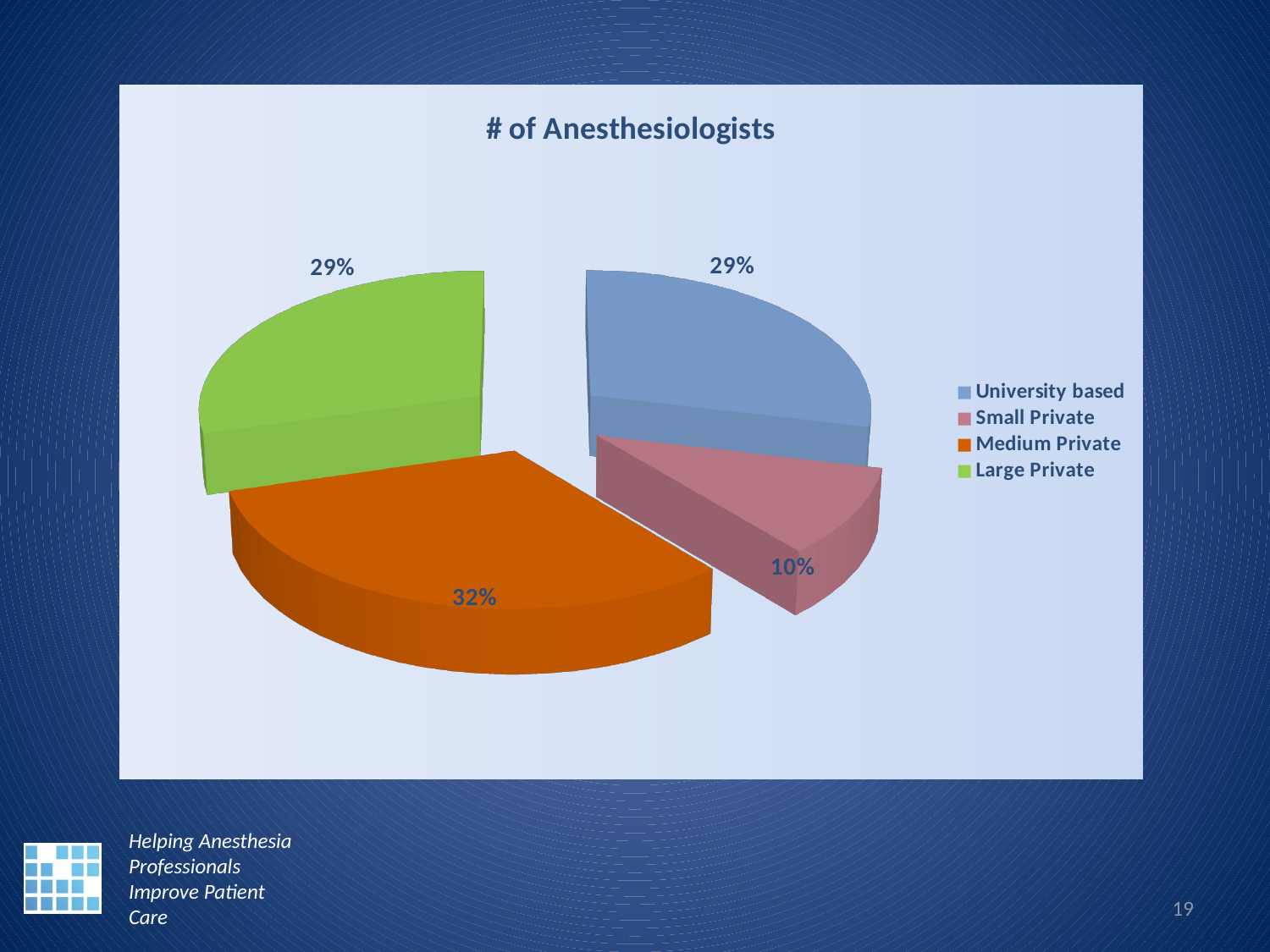
What is the difference in percentage points between Medium Private and Small Private? 22 Which category has the largest share of the pie? Medium Private What share of the pie does Large Private represent? 29% What share of the pie does Small Private represent? 10% Which category has the smallest share of the pie? Small Private What share of the pie does University based represent? 29% Which is larger, the share for Medium Private or the share for University based? Medium Private What is the title of the chart? # of Anesthesiologists What kind of chart is shown on the slide? pie chart Which colour represents Large Private in the legend? green How many categories does the pie chart show? 4